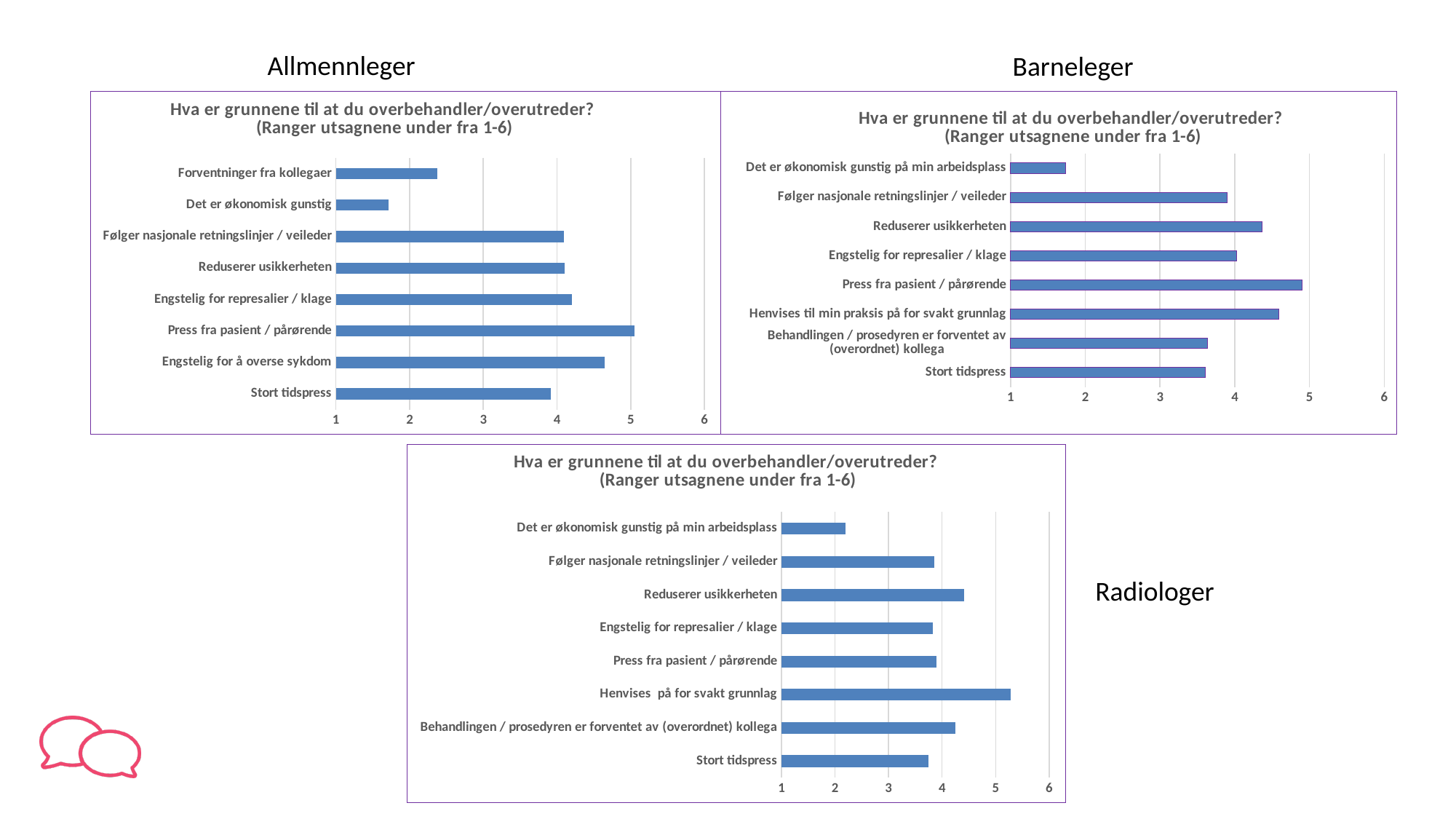
In the Allmennleger chart, which category has the highest value? Press fra pasient / pårørende In the Radiologer chart, is the value for Henvises på for svakt grunnlag greater or less than 5? greater In the Allmennleger chart, is the value for Engstelig for å overse sykdom greater or less than 4? greater In the Radiologer chart, which is larger: Reduserer usikkerheten or Stort tidspress? Reduserer usikkerheten How many categories are shown in the Barneleger chart? 8 In the Allmennleger chart, is the value for Det er økonomisk gunstig greater or less than 2? less In the Barneleger chart, which category has the lowest value? Det er økonomisk gunstig på min arbeidsplass In the Radiologer chart, which category has the highest value? Henvises på for svakt grunnlag In the Radiologer chart, which category has the lowest value? Det er økonomisk gunstig på min arbeidsplass In the Barneleger chart, which category has the highest value? Press fra pasient / pårørende In the Allmennleger chart, which category has the lowest value? Det er økonomisk gunstig